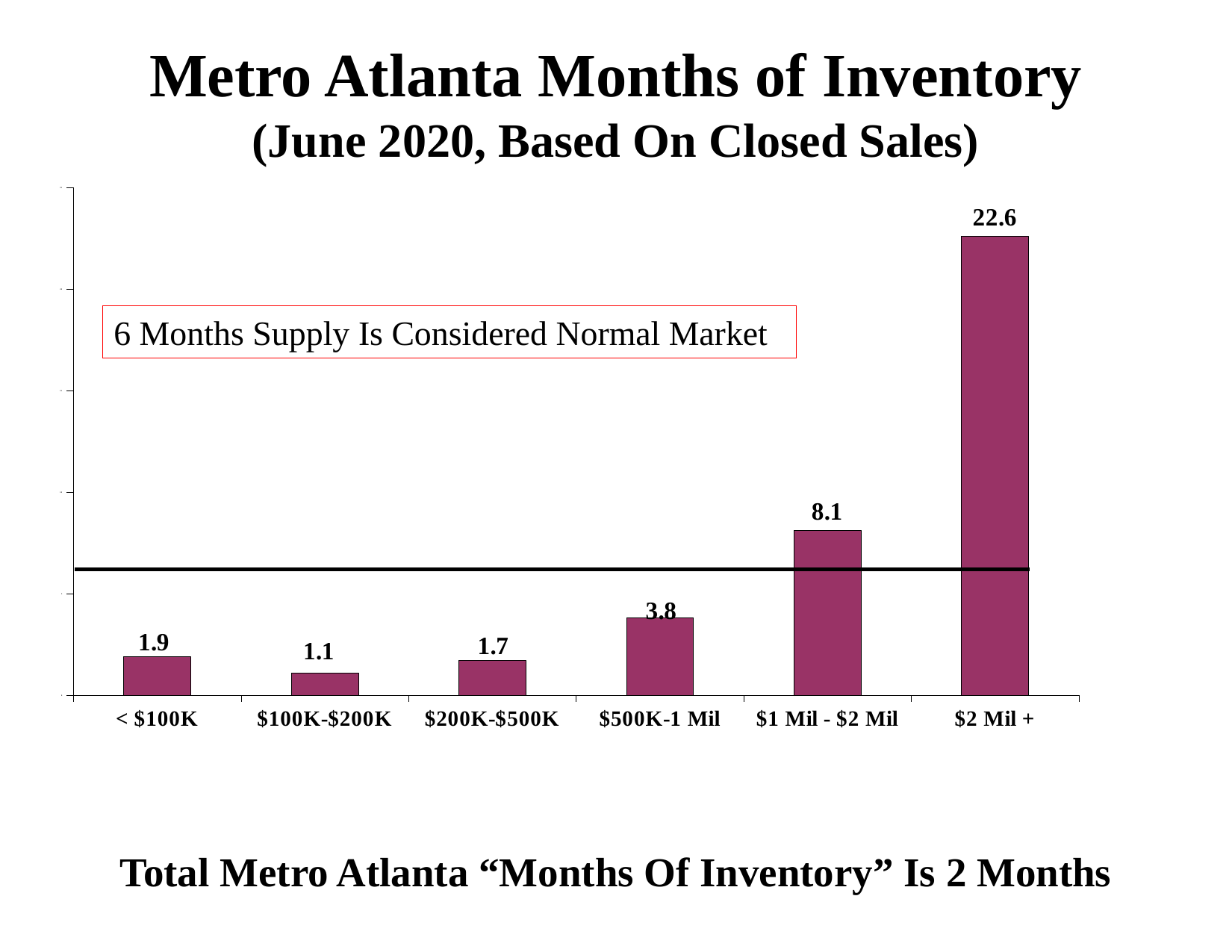
Which price range has the lowest months of inventory? $100K-$200K What kind of chart is shown on the slide? Bar chart Which has a higher months of inventory value, < $100K or $200K-$500K? < $100K What is the difference in months of inventory between the < $100K and $200K-$500K price ranges? 0.2 According to the text box on the chart, how many months of supply is considered a normal market? 6 months What is the difference in months of inventory between the $2 Mil + and $1 Mil - $2 Mil price ranges? 14.5 What is the months of inventory value for the $500K-1 Mil price range? 3.8 What is the months of inventory value for the $2 Mil + price range? 22.6 Do the months of inventory values generally rise or fall as the price ranges increase from left to right? Rise How many price range categories are shown in the chart? 6 Which price range has the highest months of inventory? $2 Mil + What is the months of inventory value for the $100K-$200K price range? 1.1